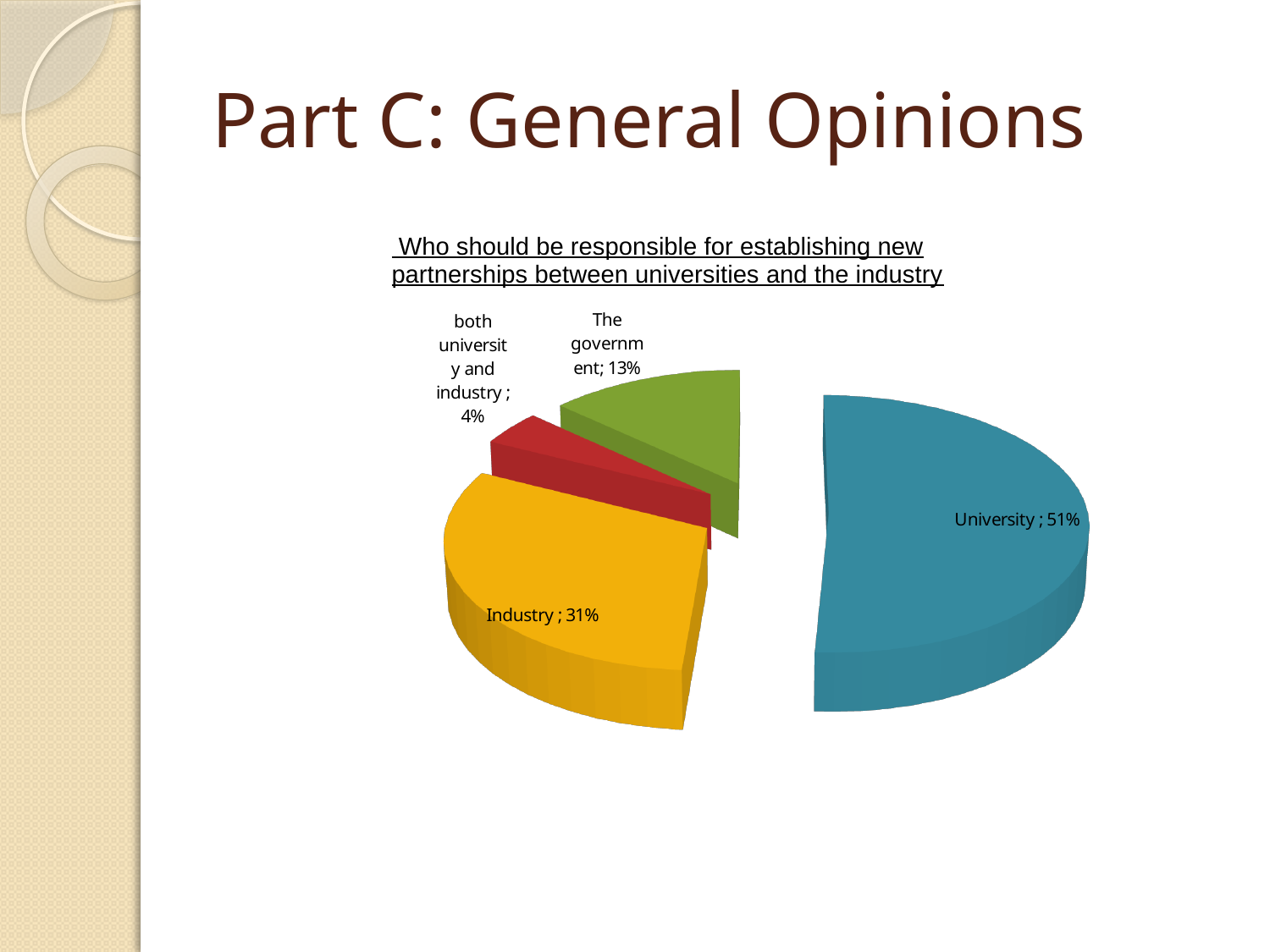
What share of the pie does University have? 51% How many slices does the pie chart have? 4 What is the difference in percentage points between University and Industry? 20 What is the difference in percentage points between The government and 'both university and industry'? 9 Which category has the smallest slice of the pie? both university and industry What kind of chart is shown on the slide? Pie chart Which is larger, the share for Industry or the share for The government? Industry What share of the pie does 'both university and industry' have? 4% What share of the pie does The government have? 13% Which category has the largest slice of the pie? University What is the title of the pie chart? Who should be responsible for establishing new partnerships between universities and the industry